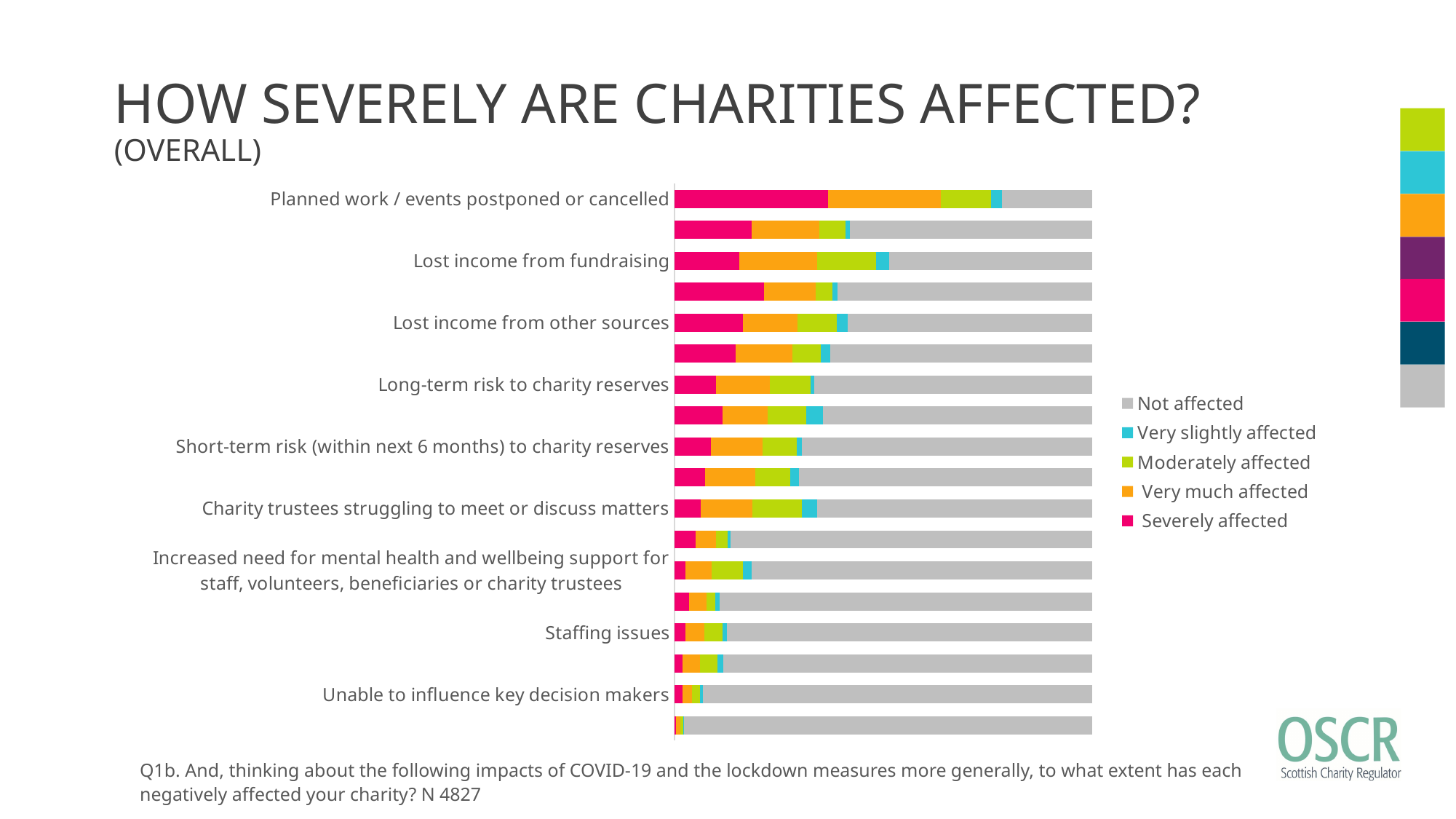
Is the 'Not affected' segment larger for 'Planned work / events postponed or cancelled' or for 'Long-term risk to charity reserves'? Long-term risk to charity reserves Which labelled category has the largest 'Not affected' segment? Unable to influence key decision makers What kind of chart is shown on the slide? Stacked bar chart Which labelled category has the largest 'Severely affected' segment? Planned work / events postponed or cancelled What is the title of the chart on the slide? HOW SEVERELY ARE CHARITIES AFFECTED? (OVERALL) Is the 'Severely affected' segment larger for 'Lost income from fundraising' or for 'Staffing issues'? Lost income from fundraising Is the 'Very much affected' segment larger for 'Lost income from other sources' or for 'Unable to influence key decision makers'? Lost income from other sources Which legend entry is shown in grey? Not affected How many series does the legend list? 5 Which labelled category has the smallest 'Severely affected' segment? Unable to influence key decision makers Which labelled category has the smallest 'Not affected' segment? Planned work / events postponed or cancelled